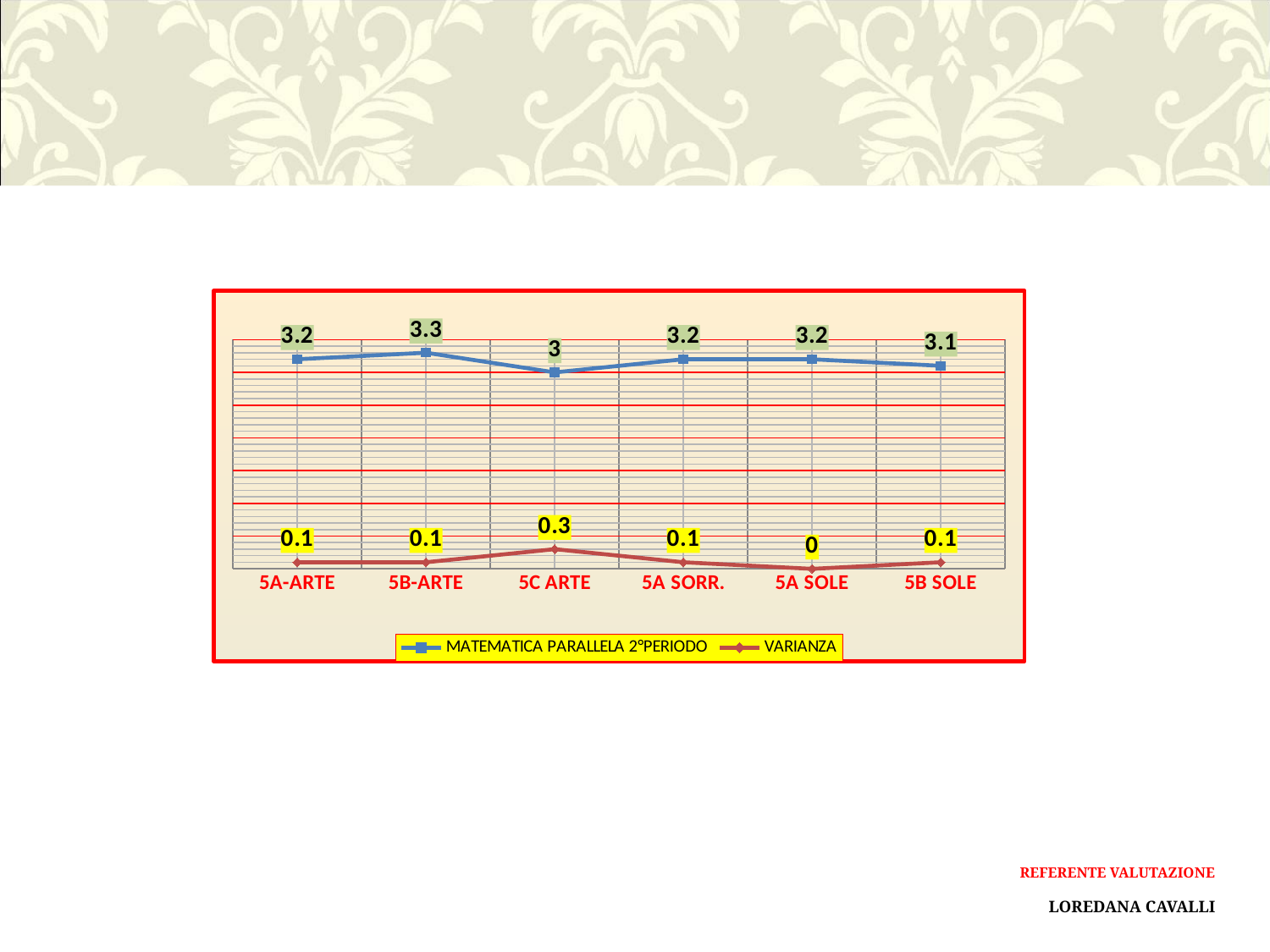
Which is larger, the MATEMATICA PARALLELA 2°PERIODO value for 5A-ARTE or for 5B SOLE? 5A-ARTE Which category has the lowest MATEMATICA PARALLELA 2°PERIODO value? 5C ARTE What is the difference between the MATEMATICA PARALLELA 2°PERIODO values for 5B-ARTE and 5C ARTE? 0.3 What is the MATEMATICA PARALLELA 2°PERIODO value for 5B SOLE? 3.1 What is the VARIANZA value for 5C ARTE? 0.3 Which category has the highest VARIANZA value? 5C ARTE How many categories are shown on the x axis? 6 Which category has the highest MATEMATICA PARALLELA 2°PERIODO value? 5B-ARTE What kind of chart is shown on the slide? Line chart How many series does the legend list? 2 What is the MATEMATICA PARALLELA 2°PERIODO value for 5B-ARTE? 3.3 What is the VARIANZA value for 5A SOLE? 0